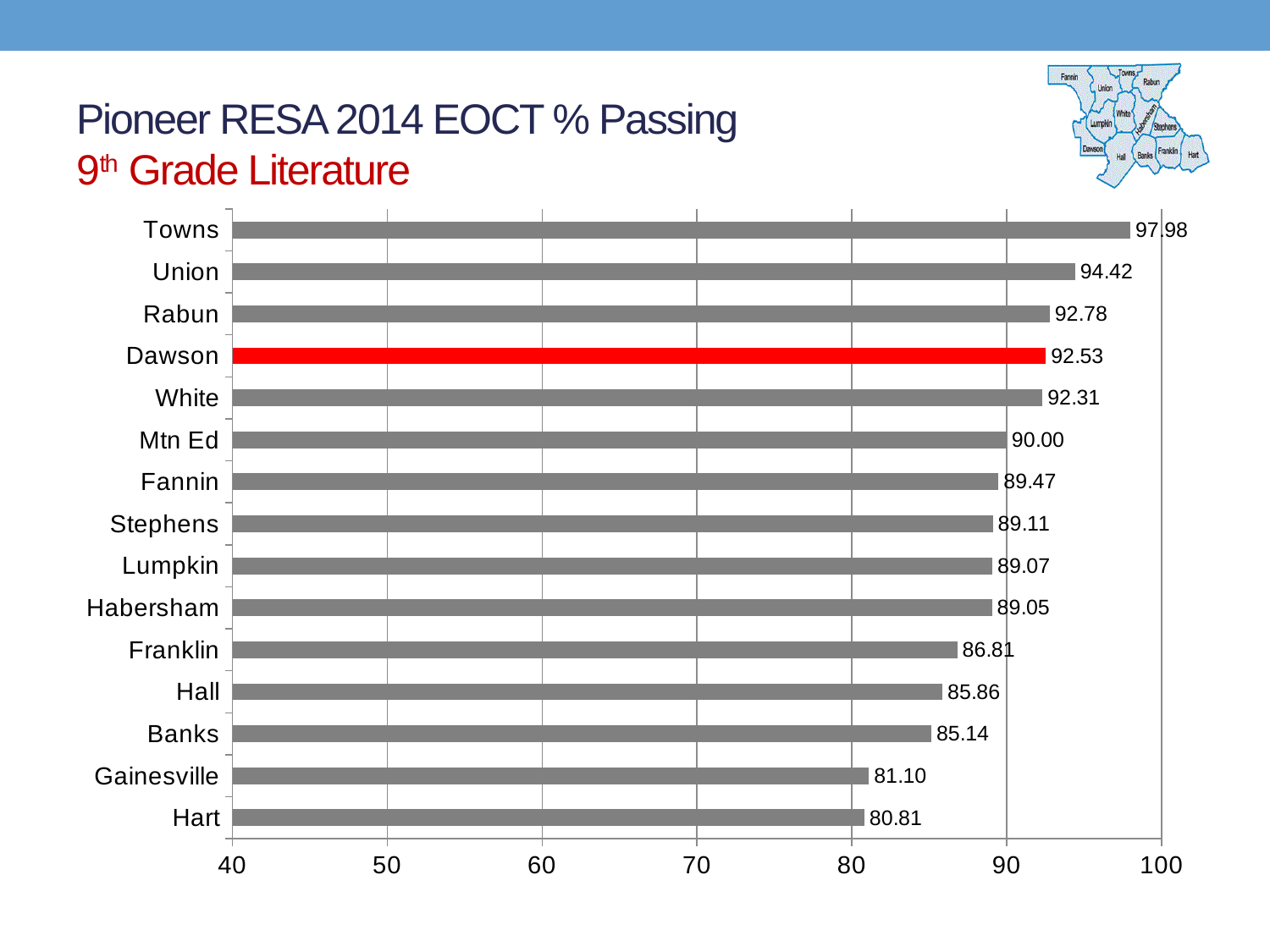
What is the value for Mtn Ed? 90.00 Is the value for Fannin greater or less than 90? less What is the value for Dawson? 92.53 Which bar is coloured red rather than grey? Dawson How many categories are shown in the chart? 15 Which is larger, the value for Franklin or the value for Hall? Franklin What kind of chart is shown on the slide? bar chart What is the difference between the values for Towns and Union? 3.56 What is the value for Gainesville? 81.10 What is the difference between the values for Hall and Banks? 0.72 Which category has the lowest value? Hart Which category has the highest value? Towns